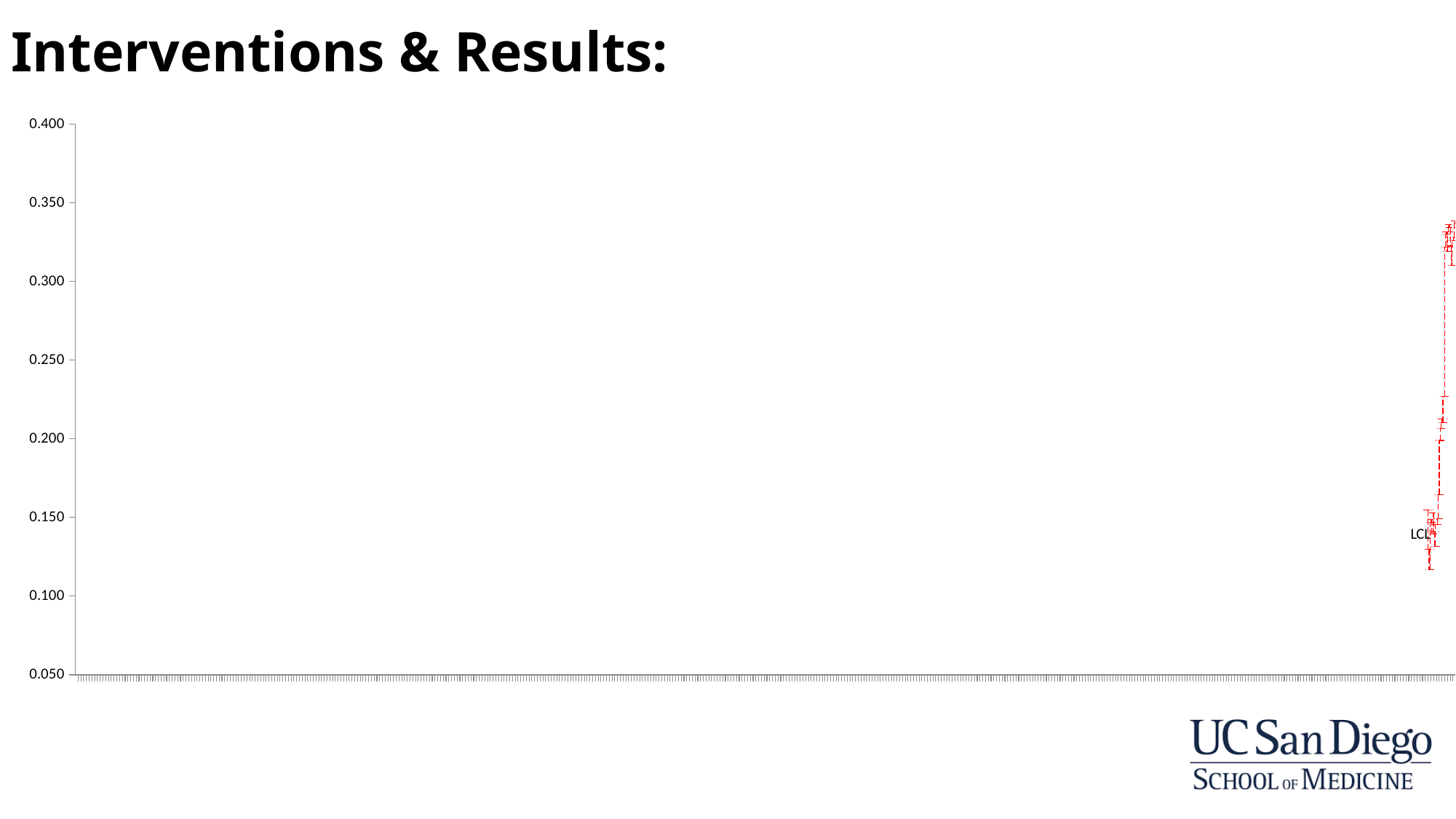
Are the red points clustered at the top right edge of the chart greater or less than 0.300? greater Are the red points next to the LCL label at the bottom right of the chart greater or less than 0.200? less What label is printed next to the lower cluster of points on the right side of the chart? LCL Are the red points at the bottom left edge of the chart greater or less than 0.200? less What is the highest value shown on the y axis of the chart? 0.400